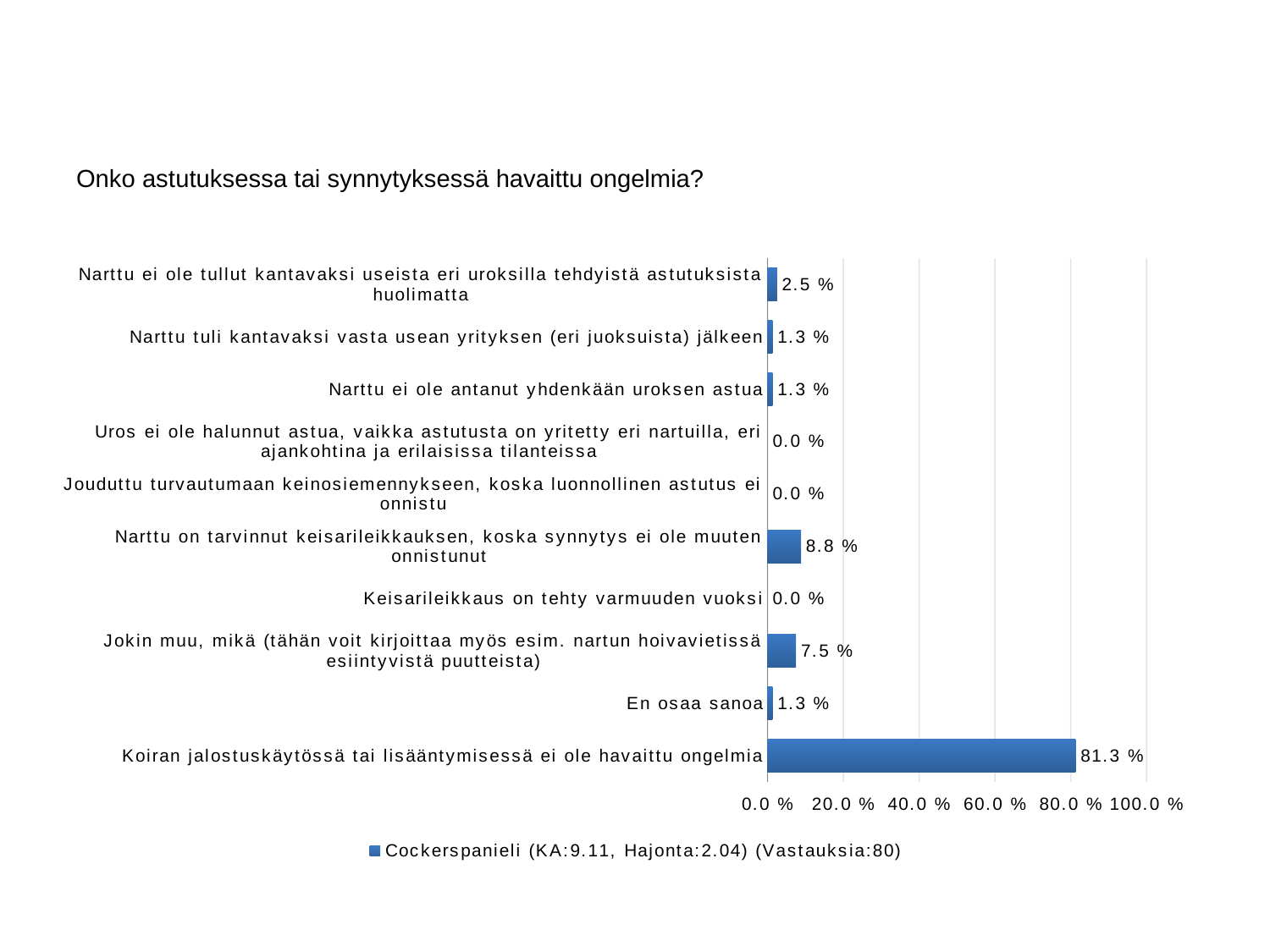
Which category has the highest value? Koiran jalostuskäytössä tai lisääntymisessä ei ole havaittu ongelmia Is the value for "Koiran jalostuskäytössä tai lisääntymisessä ei ole havaittu ongelmia" greater or less than 80.0 %? greater What kind of chart is shown on the slide? Bar chart What is the legend entry of the chart? Cockerspanieli (KA:9.11, Hajonta:2.04) (Vastauksia:80) What is the value for "Jokin muu, mikä"? 7.5 % What is the difference between the values for "Narttu on tarvinnut keisarileikkauksen" and "Jokin muu, mikä"? 1.3 % How many categories are shown in the chart? 10 What is the value for "Koiran jalostuskäytössä tai lisääntymisessä ei ole havaittu ongelmia"? 81.3 % What is the value for "Narttu on tarvinnut keisarileikkauksen, koska synnytys ei ole muuten onnistunut"? 8.8 % How many categories have a value of 0.0 %? 3 Which is larger: the value for "Narttu on tarvinnut keisarileikkauksen" or the value for "Narttu ei ole tullut kantavaksi useista eri uroksilla tehdyistä astutuksista huolimatta"? Narttu on tarvinnut keisarileikkauksen What is the value for "Narttu ei ole tullut kantavaksi useista eri uroksilla tehdyistä astutuksista huolimatta"? 2.5 %